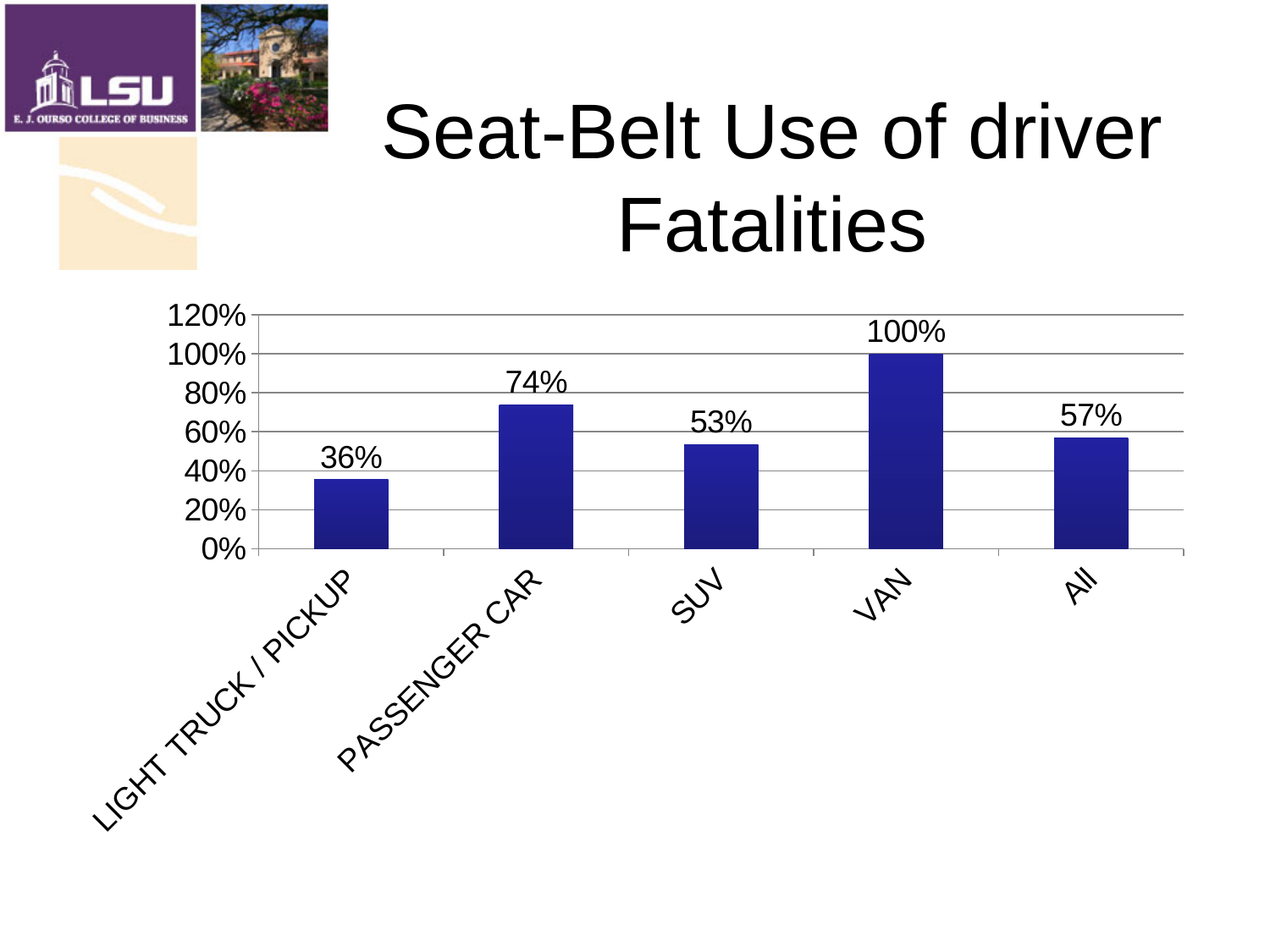
What is the title of the slide containing the chart? Seat-Belt Use of driver Fatalities Which category has the lowest value? LIGHT TRUCK / PICKUP What kind of chart is shown on the slide? bar chart Is the value for SUV greater or less than 60%? less Which category has the highest value? VAN What is the value for SUV? 53% How many categories are shown on the x axis? 5 What is the value for VAN? 100% Which is larger, the value for PASSENGER CAR or the value for All? PASSENGER CAR What is the value for All? 57% What is the difference between the values for PASSENGER CAR and SUV? 21% What is the value for LIGHT TRUCK / PICKUP? 36%